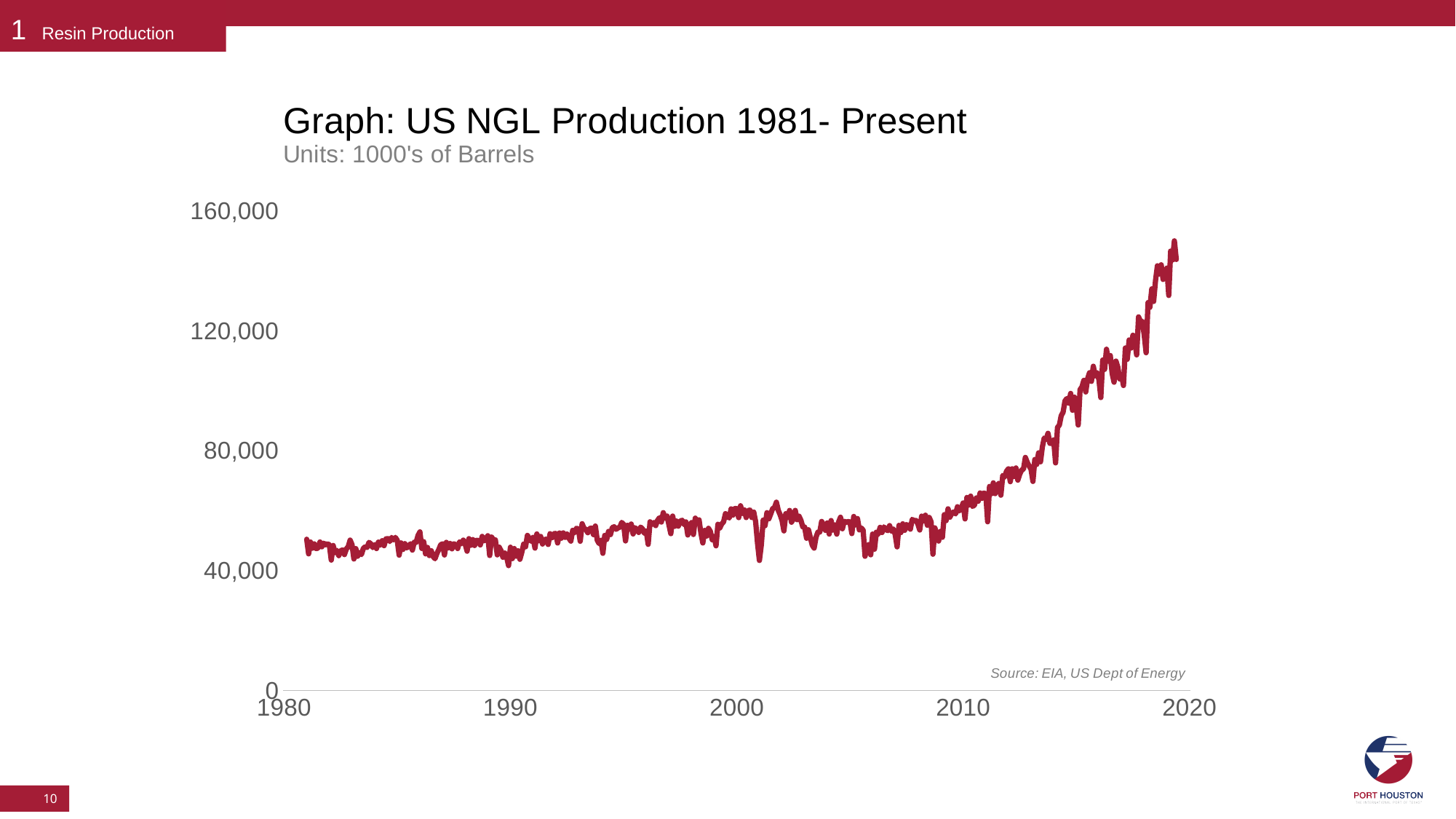
What is the highest value shown on the y axis? 160,000 What is the title of the chart? Graph: US NGL Production 1981- Present Is the value around 2010 greater or less than 80,000? less Is the value around 2015 greater or less than 80,000? greater Is the value around 1990 greater or less than 80,000? less Overall, do the values rise or fall from 1981 to the end of the series? rise In which decade does the series reach its highest values? 2010s Which is larger, the value around 2019 or the value around 1990? around 2019 What kind of chart is shown on the slide? line chart What units does the chart use for the y axis? 1000's of Barrels